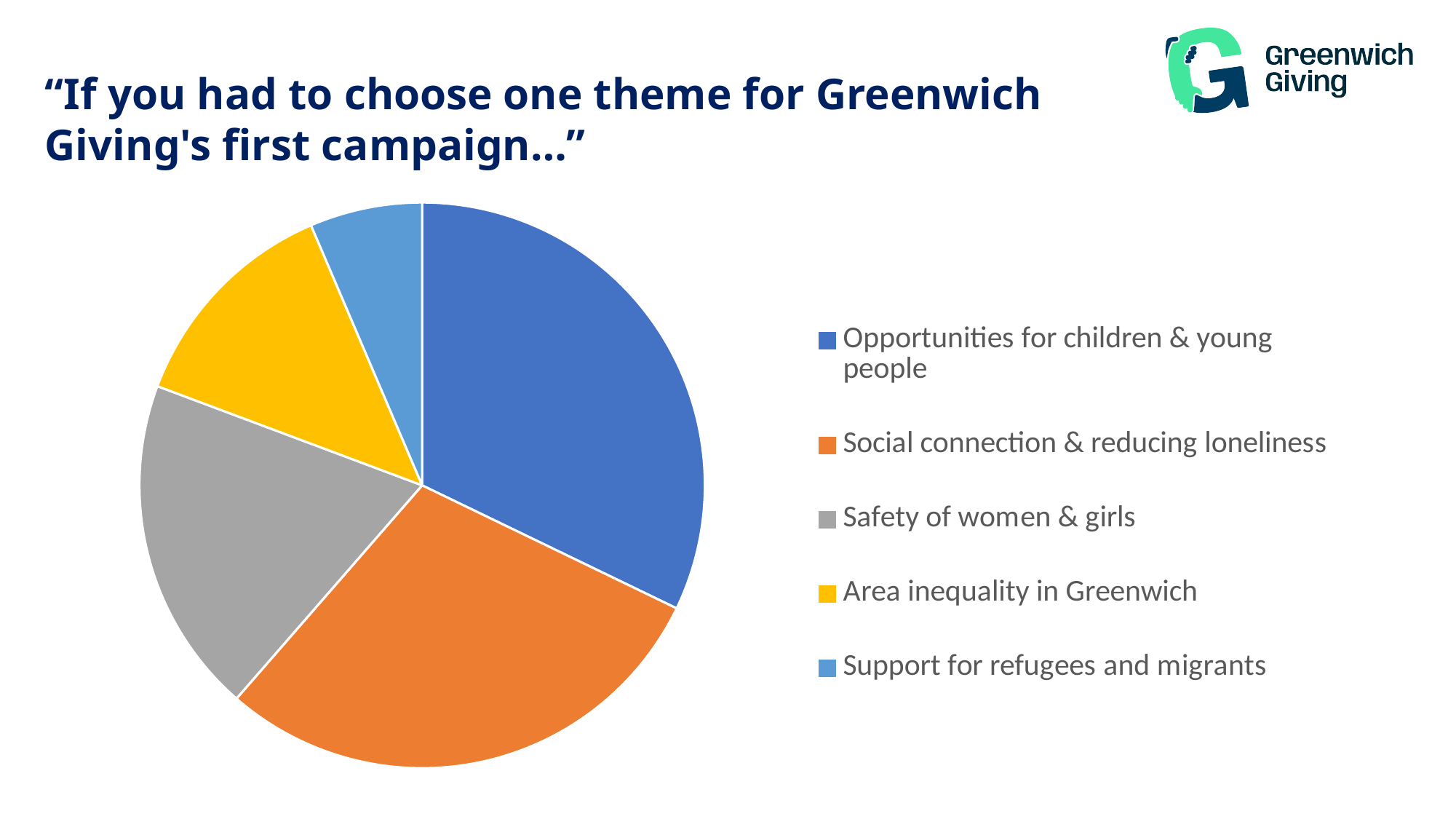
What kind of chart is shown on the slide? Pie chart Which slice is larger: Social connection & reducing loneliness or Safety of women & girls? Social connection & reducing loneliness How many slices does the pie chart have? 5 Which theme has the largest slice of the pie chart? Opportunities for children & young people Which slice is larger: Area inequality in Greenwich or Support for refugees and migrants? Area inequality in Greenwich Which theme has the smallest slice of the pie chart? Support for refugees and migrants Which theme is shown in orange on the pie chart? Social connection & reducing loneliness Which slice is larger: Opportunities for children & young people or Support for refugees and migrants? Opportunities for children & young people What colour is the slice for Area inequality in Greenwich? Yellow